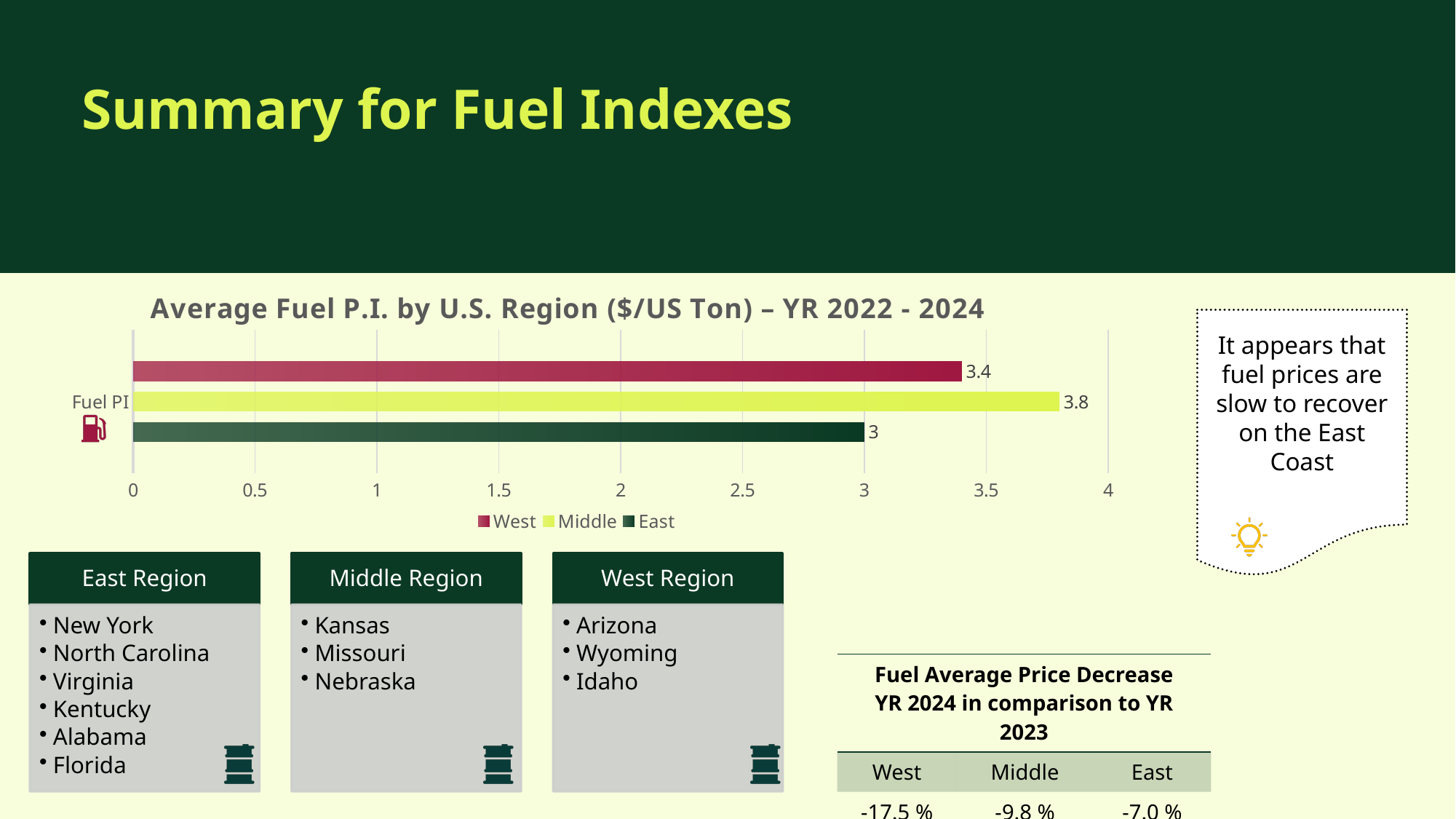
What is the difference between the West and East values in the Average Fuel P.I. by U.S. Region chart? 0.4 What kind of chart is the Average Fuel P.I. by U.S. Region chart? bar chart How many series does the legend of the Average Fuel P.I. by U.S. Region chart list? 3 What is the value for the East series in the Average Fuel P.I. by U.S. Region chart? 3 What is the difference between the Middle and East values in the Average Fuel P.I. by U.S. Region chart? 0.8 What is the value for the Middle series in the Average Fuel P.I. by U.S. Region chart? 3.8 What is the value for the West series in the Average Fuel P.I. by U.S. Region chart? 3.4 Which is larger in the Average Fuel P.I. by U.S. Region chart, the West value or the Middle value? Middle Which series has the highest value in the Average Fuel P.I. by U.S. Region chart? Middle Which series has the lowest value in the Average Fuel P.I. by U.S. Region chart? East What is the title of the chart on the slide? Average Fuel P.I. by U.S. Region ($/US Ton) – YR 2022 - 2024 Is the value for West in the Average Fuel P.I. by U.S. Region chart greater or less than 3.5? less